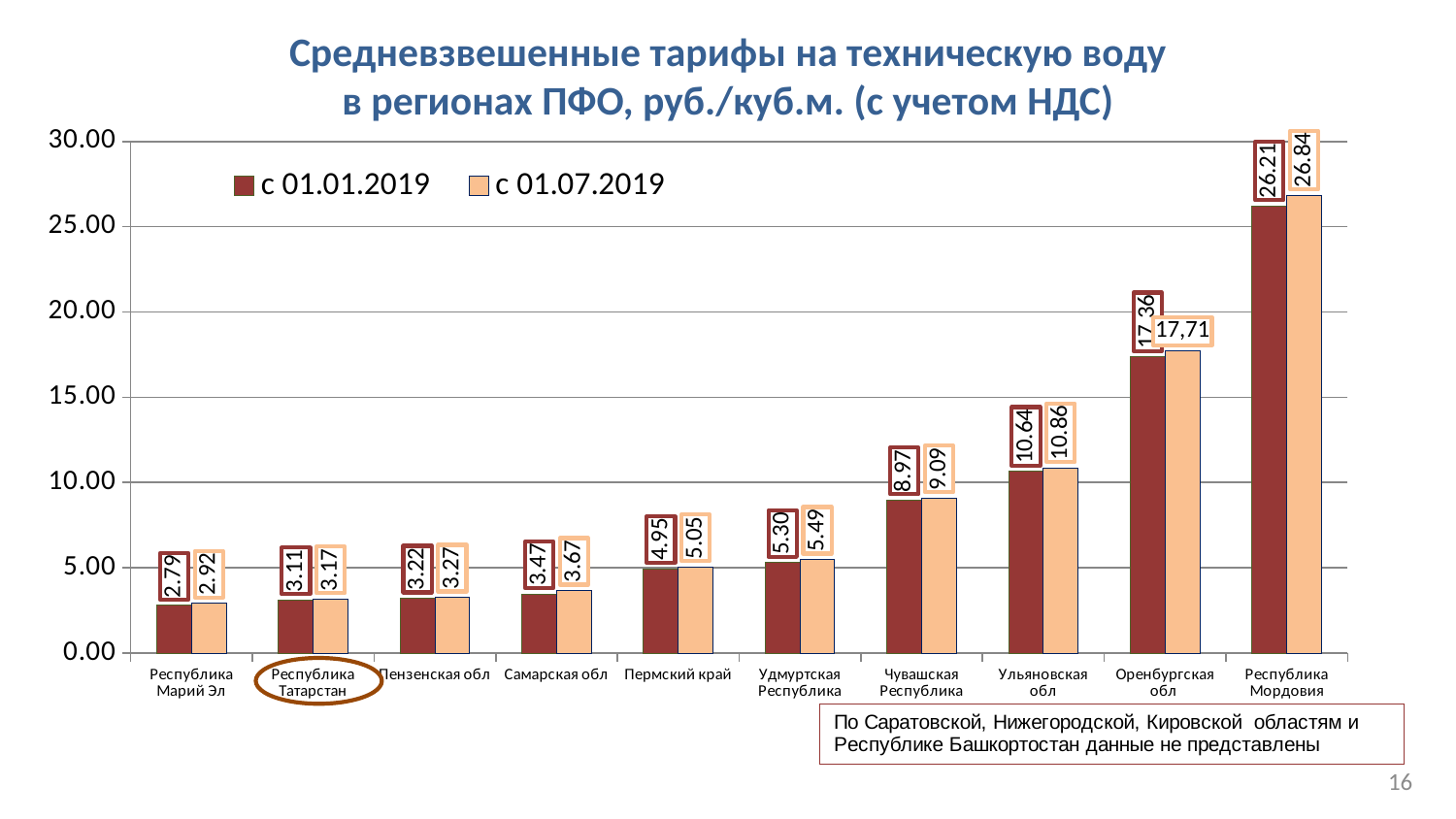
Do the values in the series с 01.01.2019 rise or fall from left to right along the x axis? rise How many regions are shown on the x axis? 10 What is the value for Оренбургская обл in the series с 01.07.2019? 17,71 Which is larger for Самарская обл: the value for с 01.01.2019 or for с 01.07.2019? с 01.07.2019 What is the value for Республика Татарстан in the series с 01.07.2019? 3.17 What kind of chart is shown on the slide? bar chart What is the value for Ульяновская обл in the series с 01.01.2019? 10.64 How many series does the legend list? 2 Which region has the lowest value in the series с 01.01.2019? Республика Марий Эл What is the difference between the с 01.07.2019 and с 01.01.2019 values for Республика Мордовия? 0.63 Which region has the highest value in the series с 01.07.2019? Республика Мордовия Which region on the x axis is circled? Республика Татарстан